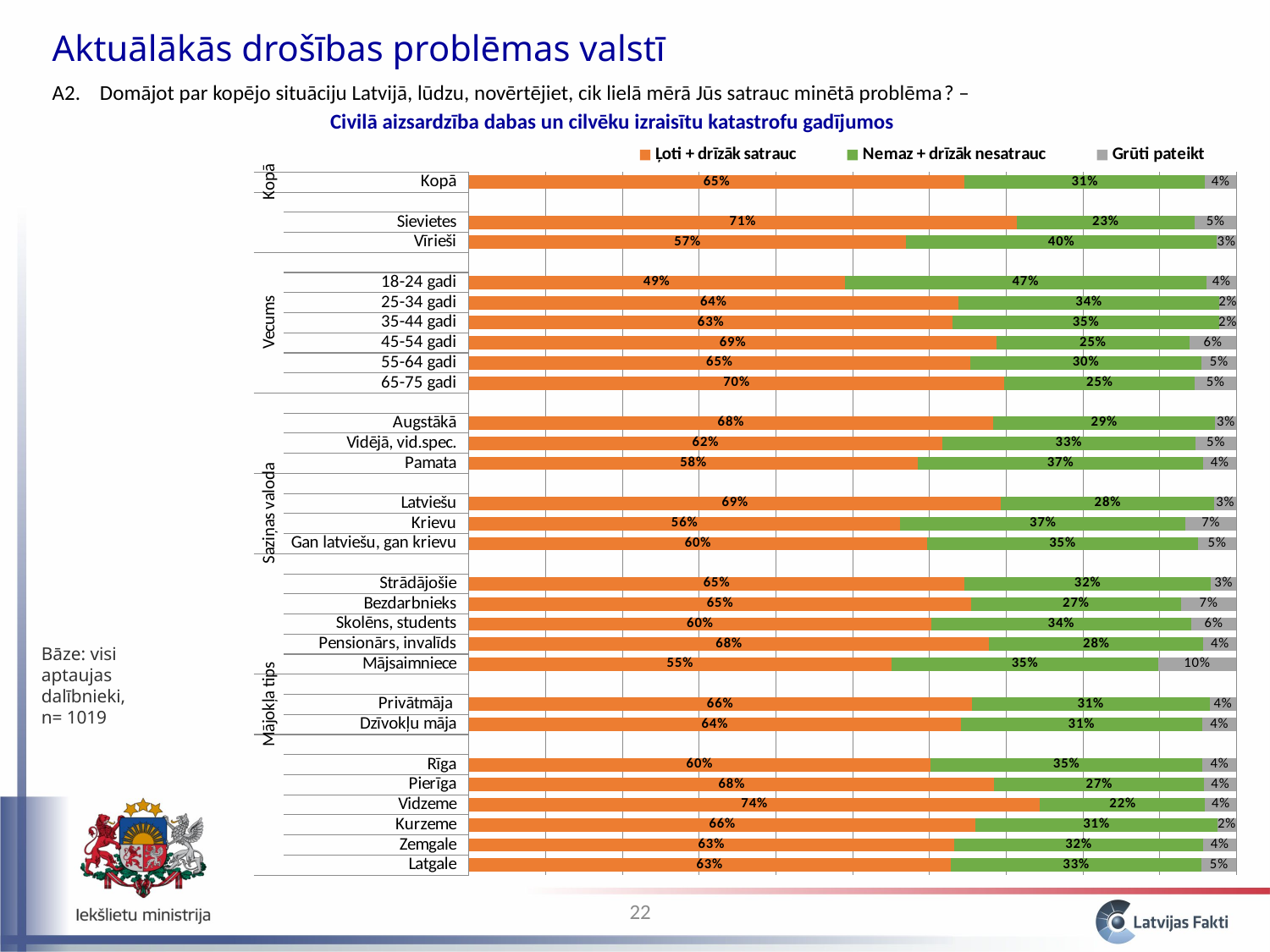
Which category has the highest value for "Ļoti + drīzāk satrauc"? Vidzeme Which category has the highest value for "Grūti pateikt"? Mājsaimniece What is the total of the three segments for the Kopā bar? 100% What is the value of "Grūti pateikt" for Mājsaimniece? 10% Which category has the lowest value for "Ļoti + drīzāk satrauc"? 18-24 gadi What is the title of the chart? Civilā aizsardzība dabas un cilvēku izraisītu katastrofu gadījumos How many series does the legend list? 3 What is the difference between the "Ļoti + drīzāk satrauc" values for Sievietes and Vīrieši? 14 percentage points Which has a larger "Nemaz + drīzāk nesatrauc" value, 18-24 gadi or 65-75 gadi? 18-24 gadi What is the value of "Nemaz + drīzāk nesatrauc" for Vīrieši? 40% What is the value of "Ļoti + drīzāk satrauc" for Kopā? 65% What type of chart is shown on the slide? stacked bar chart